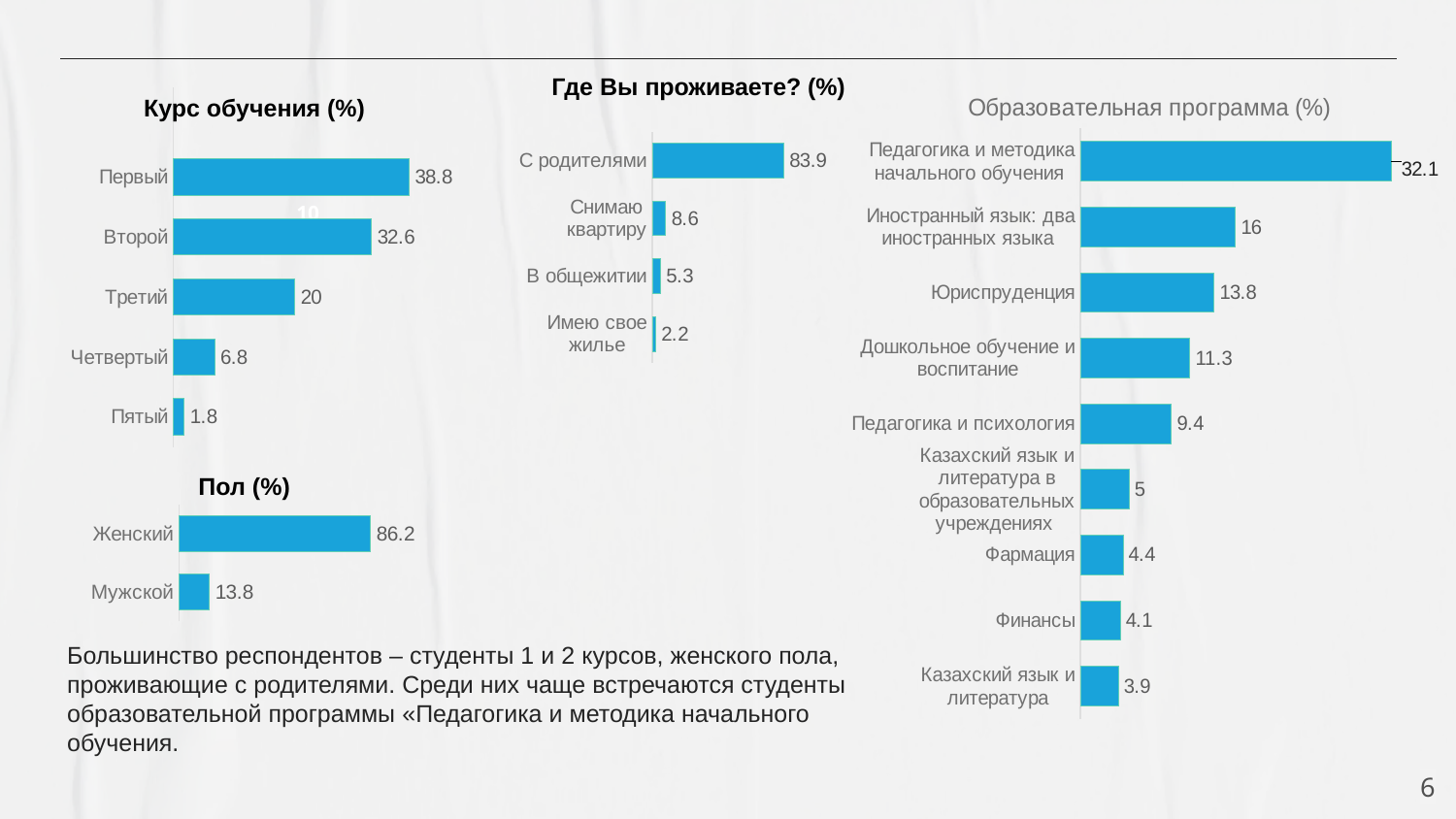
In the "Пол (%)" chart, what is the difference between "Женский" and "Мужской"? 72.4 In the "Пол (%)" chart, what is the value for "Мужской"? 13.8 In the "Где Вы проживаете? (%)" chart, what is the value for "Снимаю квартиру"? 8.6 What type of chart is the "Образовательная программа (%)" chart? Bar chart In the "Образовательная программа (%)" chart, how many categories are shown? 9 In the "Образовательная программа (%)" chart, what is the value for "Юриспруденция"? 13.8 In the "Курс обучения (%)" chart, what is the difference between "Первый" and "Второй"? 6.2 In the "Где Вы проживаете? (%)" chart, which category has the highest value? С родителями In the "Где Вы проживаете? (%)" chart, which is larger: "В общежитии" or "Имею свое жилье"? В общежитии In the "Курс обучения (%)" chart, which category has the lowest value? Пятый In the "Курс обучения (%)" chart, what is the value for "Третий"? 20 In the "Курс обучения (%)" chart, how many categories are shown? 5